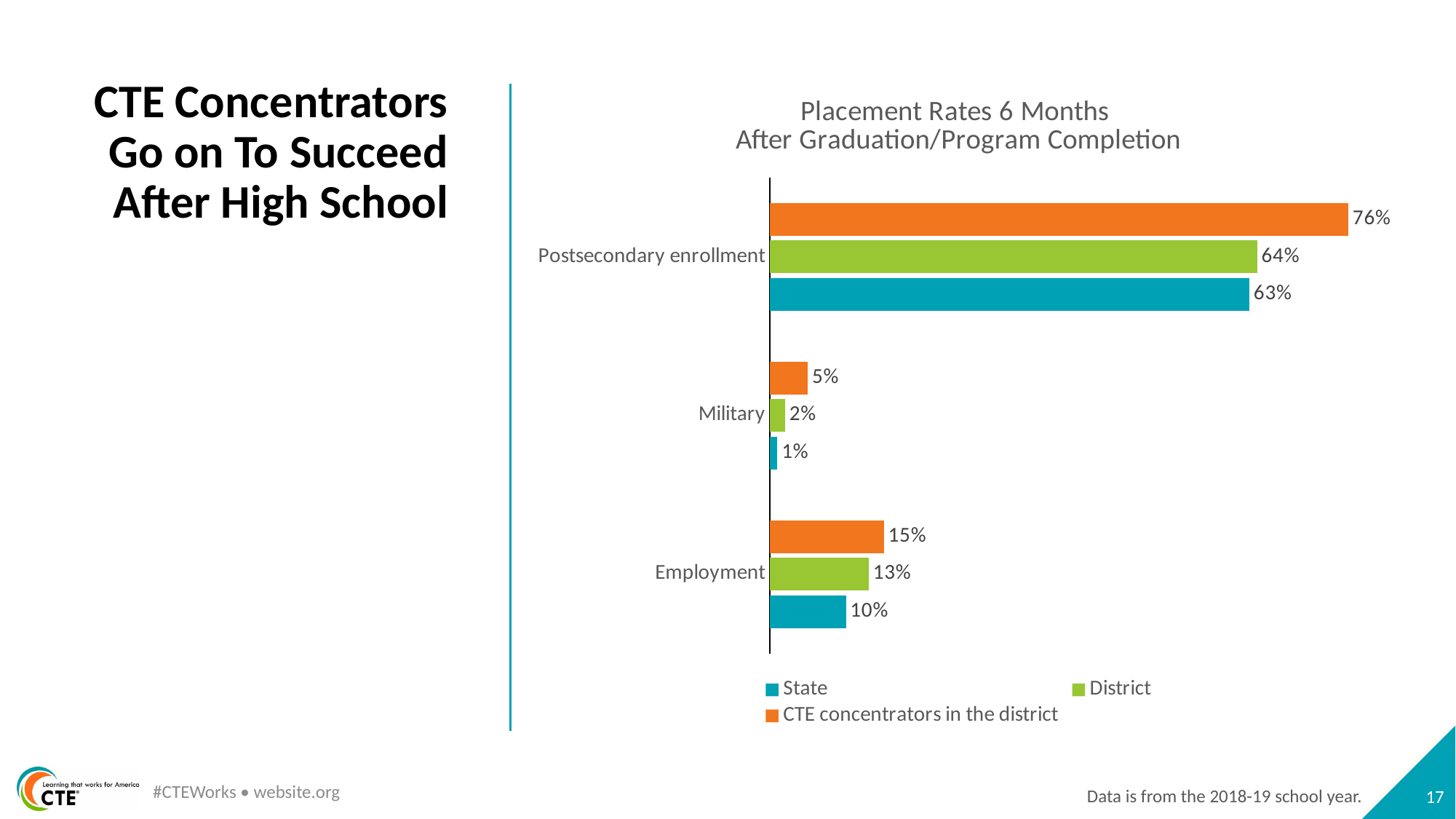
How many series does the legend list? 3 What is the State value for Military placement? 1% What is the District value for Employment? 13% What is the title of the chart? Placement Rates 6 Months After Graduation/Program Completion What is the difference between the District and State values for Employment? 3% How many categories are shown on the chart? 3 For Employment, which is larger: the CTE concentrators in the district value or the State value? CTE concentrators in the district Which category has the lowest value for CTE concentrators in the district? Military Which category has the highest value for the State series? Postsecondary enrollment What is the postsecondary enrollment rate for CTE concentrators in the district? 76% What is the difference between the CTE concentrators in the district and State values for Postsecondary enrollment? 13% What kind of chart is shown on the slide? Bar chart